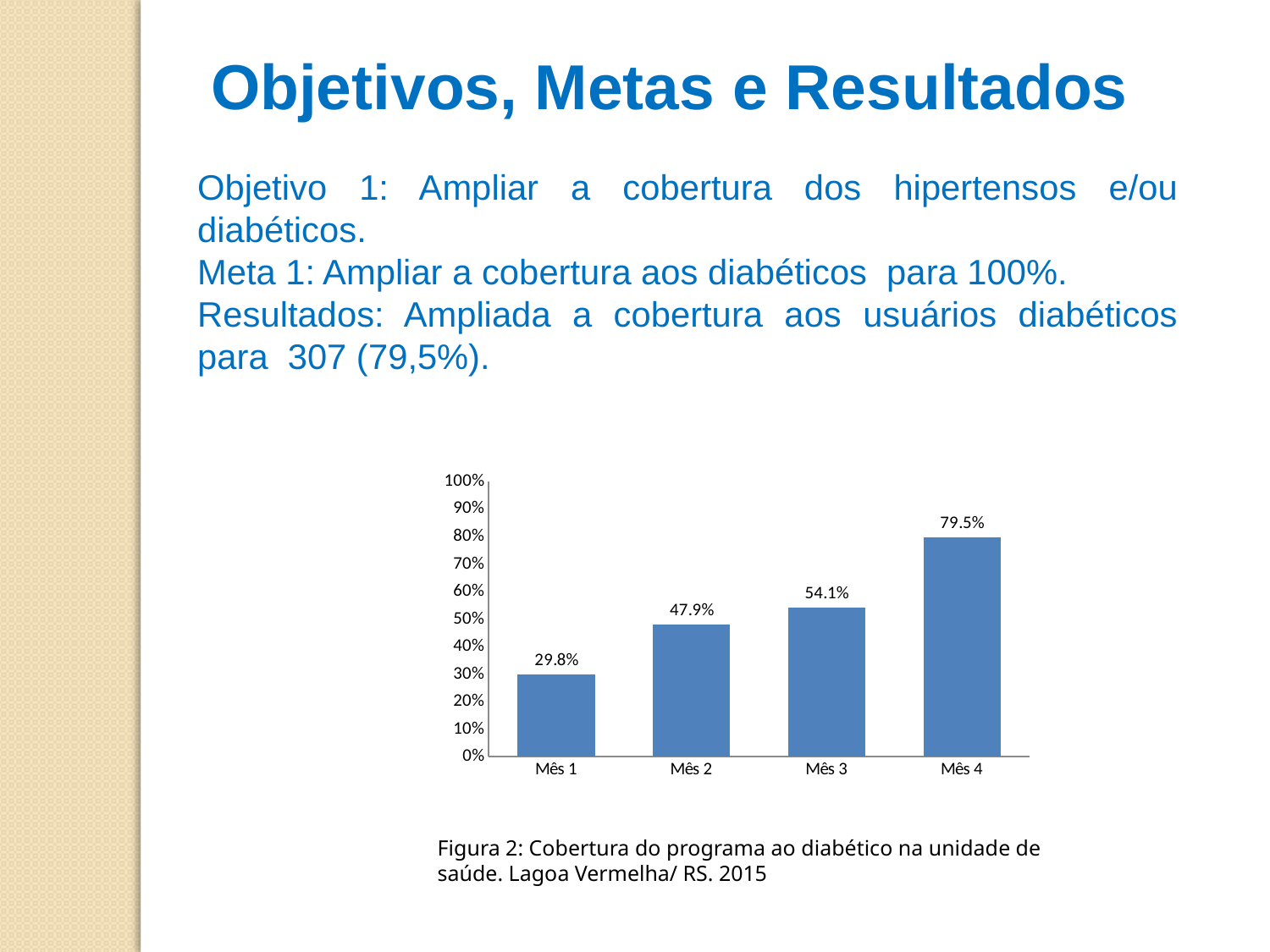
Which is larger, the value for Mês 2 or the value for Mês 3? Mês 3 What is the value for Mês 1? 29.8% What is the difference between the values for Mês 4 and Mês 1? 49.7% Which month has the lowest coverage value? Mês 1 Do the values rise or fall from Mês 1 to Mês 4? rise What is the value for Mês 4? 79.5% What kind of chart is shown on the slide? bar chart Is the value for Mês 4 greater or less than 70%? greater What is the value for Mês 2? 47.9% What is the value for Mês 3? 54.1% How many months are shown on the x axis of the chart? 4 Which month has the highest coverage value? Mês 4